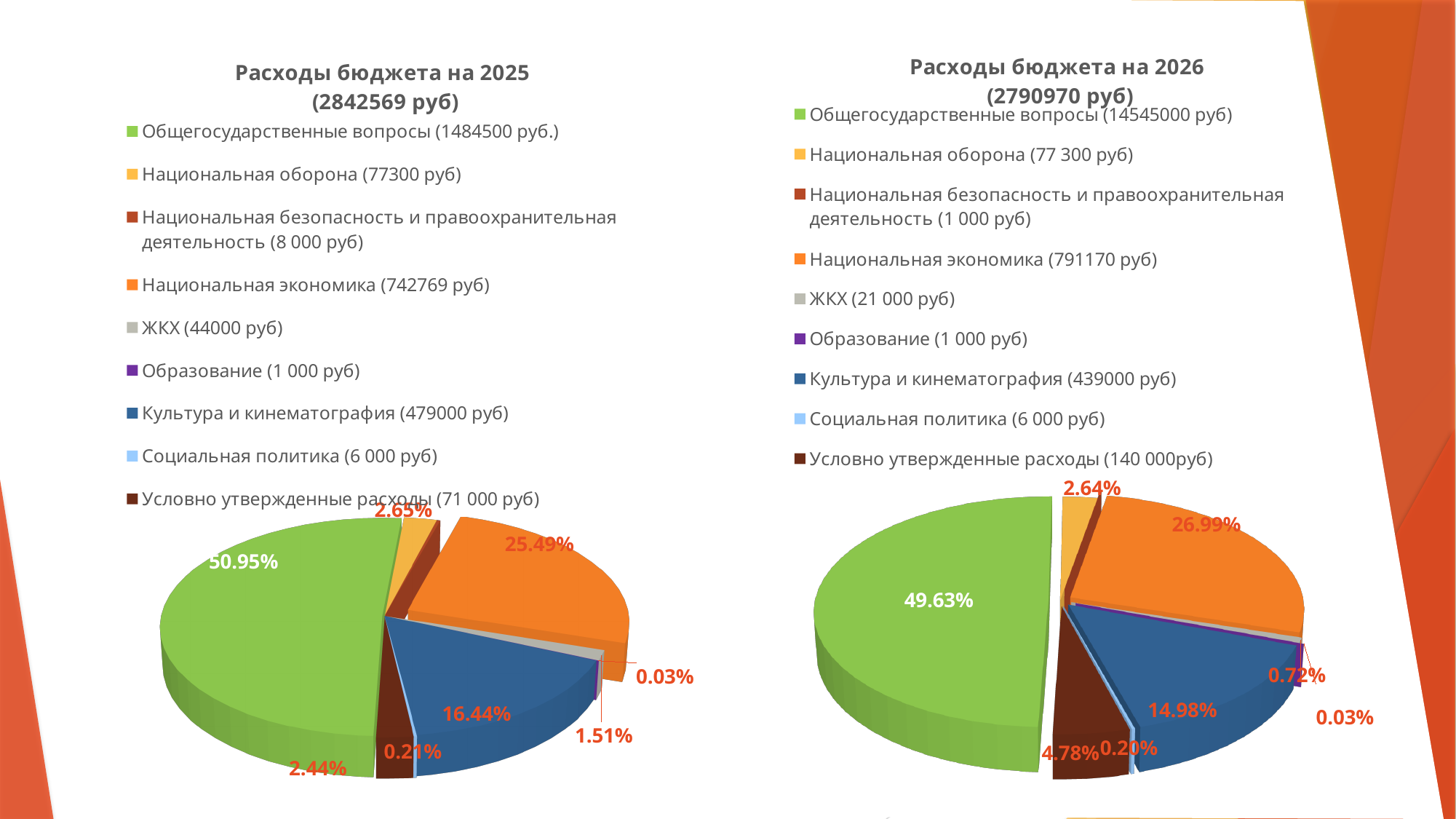
In the left chart 'Расходы бюджета на 2025', what is the difference between the green slice (50.95%) and the orange slice (25.49%)? 25.46% In the left chart 'Расходы бюджета на 2025', what percentage is labelled on the blue slice? 16.44% In the left chart 'Расходы бюджета на 2025', what percentage is shown on the largest (green) slice? 50.95% How many categories does the legend of the right chart 'Расходы бюджета на 2026' list? 9 In the right chart 'Расходы бюджета на 2026', what percentage is shown on the largest (green) slice? 49.63% What total budget amount is shown in the title of the left chart 'Расходы бюджета на 2025'? 2842569 руб What kind of chart is the left chart, 'Расходы бюджета на 2025'? Pie chart In the right chart 'Расходы бюджета на 2026', what percentage is labelled on the orange slice? 26.99% In the left chart 'Расходы бюджета на 2025', which legend category has the largest share of the pie? Общегосударственные вопросы In the right chart 'Расходы бюджета на 2026', what percentage is labelled on the blue slice? 14.98% Which chart has a larger share for the orange slice: the 2025 chart (25.49%) or the 2026 chart (26.99%)? The 2026 chart In the left chart 'Расходы бюджета на 2025', what percentage is labelled on the orange slice? 25.49%